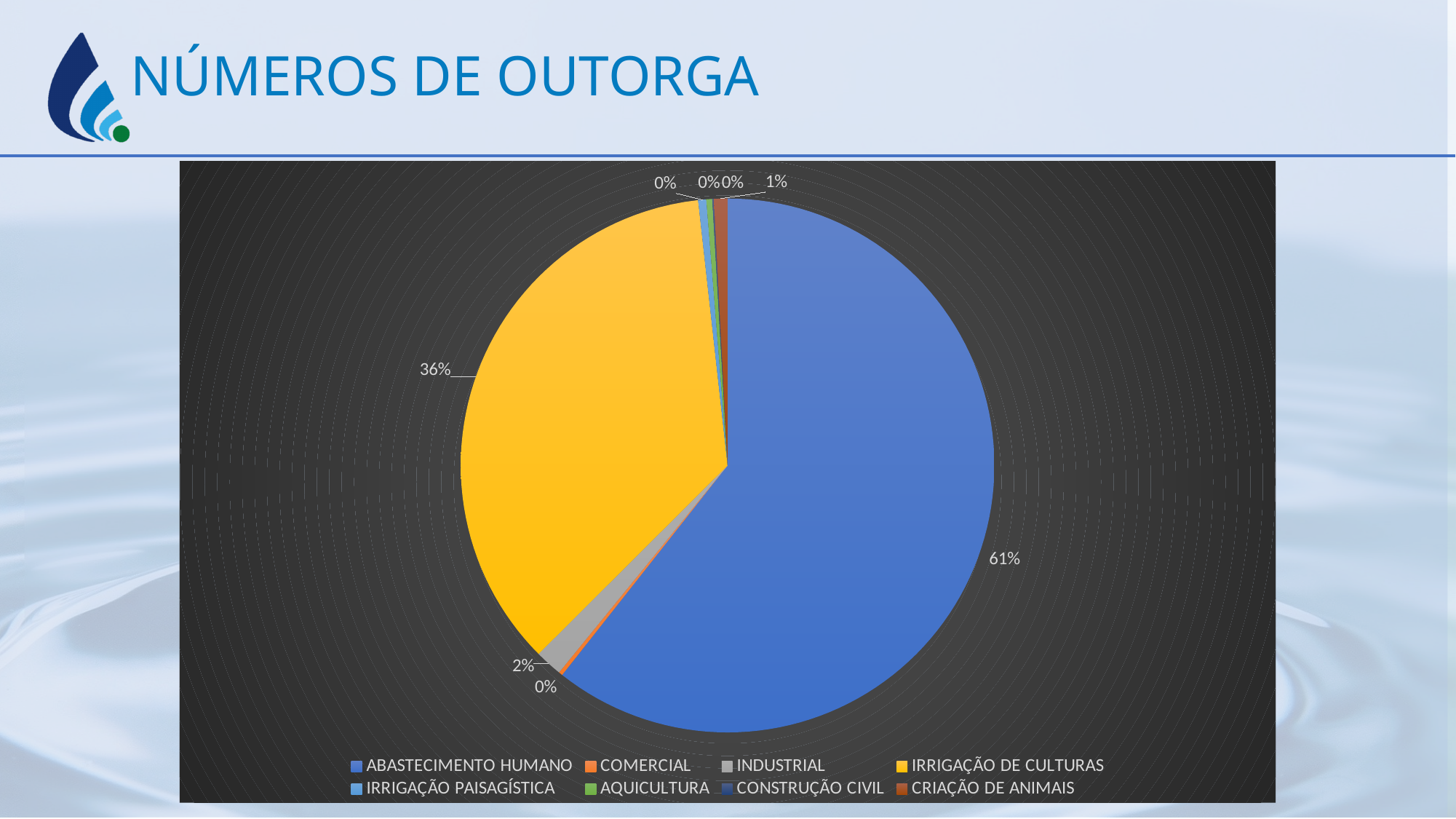
What share of the pie does ABASTECIMENTO HUMANO represent? 61% What is the title of the slide containing the pie chart? NÚMEROS DE OUTORGA Which is larger, the slice for INDUSTRIAL or the slice for CRIAÇÃO DE ANIMAIS? INDUSTRIAL What percentage is shown for CRIAÇÃO DE ANIMAIS? 1% What percentage is shown for INDUSTRIAL? 2% What colour is the slice for IRRIGAÇÃO DE CULTURAS? yellow What kind of chart is shown on the slide? pie chart What share of the pie does IRRIGAÇÃO DE CULTURAS represent? 36% Is the share for ABASTECIMENTO HUMANO greater or less than 50%? greater Which category has the largest slice of the pie? ABASTECIMENTO HUMANO What is the difference in percentage points between ABASTECIMENTO HUMANO and IRRIGAÇÃO DE CULTURAS? 25 percentage points How many categories does the legend of the pie chart list? 8